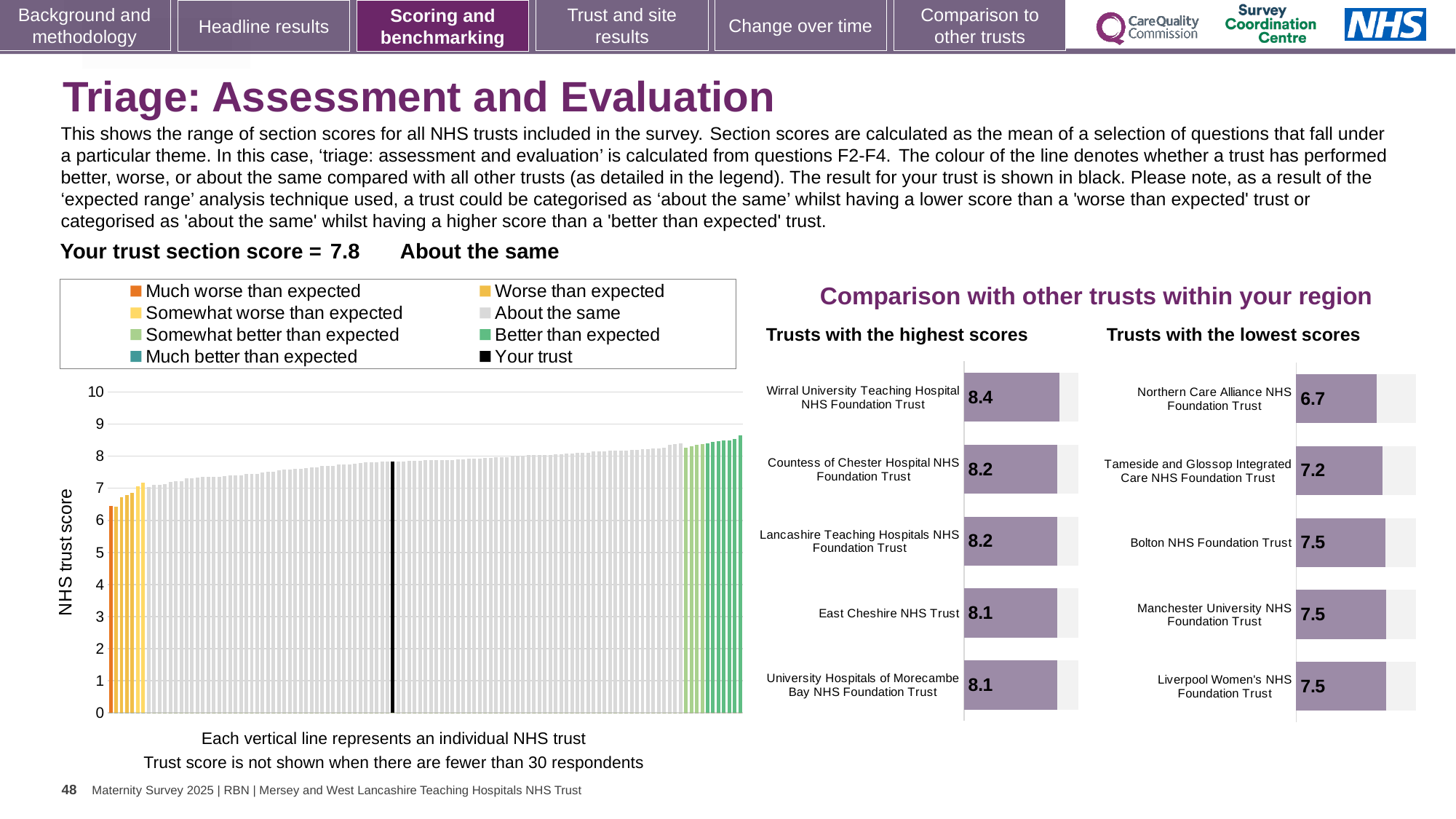
What kind of chart is the large chart on the left showing the range of section scores for all NHS trusts? bar chart In the 'Trusts with the highest scores' chart, what is the score for Wirral University Teaching Hospital NHS Foundation Trust? 8.4 In the large chart on the left, is the value for your trust (the black bar) greater or less than 7? greater In the 'Trusts with the highest scores' chart, what is the difference between the scores of Wirral University Teaching Hospital NHS Foundation Trust and East Cheshire NHS Trust? 0.3 In the 'Trusts with the lowest scores' chart, which trust has the lowest score? Northern Care Alliance NHS Foundation Trust How many entries does the legend above the large chart on the left list? 8 In the 'Trusts with the lowest scores' chart, which has the larger score: Bolton NHS Foundation Trust or Tameside and Glossop Integrated Care NHS Foundation Trust? Bolton NHS Foundation Trust In the 'Trusts with the highest scores' chart, which trust has the highest score? Wirral University Teaching Hospital NHS Foundation Trust In the 'Trusts with the lowest scores' chart, what is the score for Tameside and Glossop Integrated Care NHS Foundation Trust? 7.2 In the 'Trusts with the highest scores' chart, how many trusts are shown? 5 In the large chart on the left, do the trust scores rise or fall from left to right? rise In the large chart on the left, what is the label on the vertical axis? NHS trust score